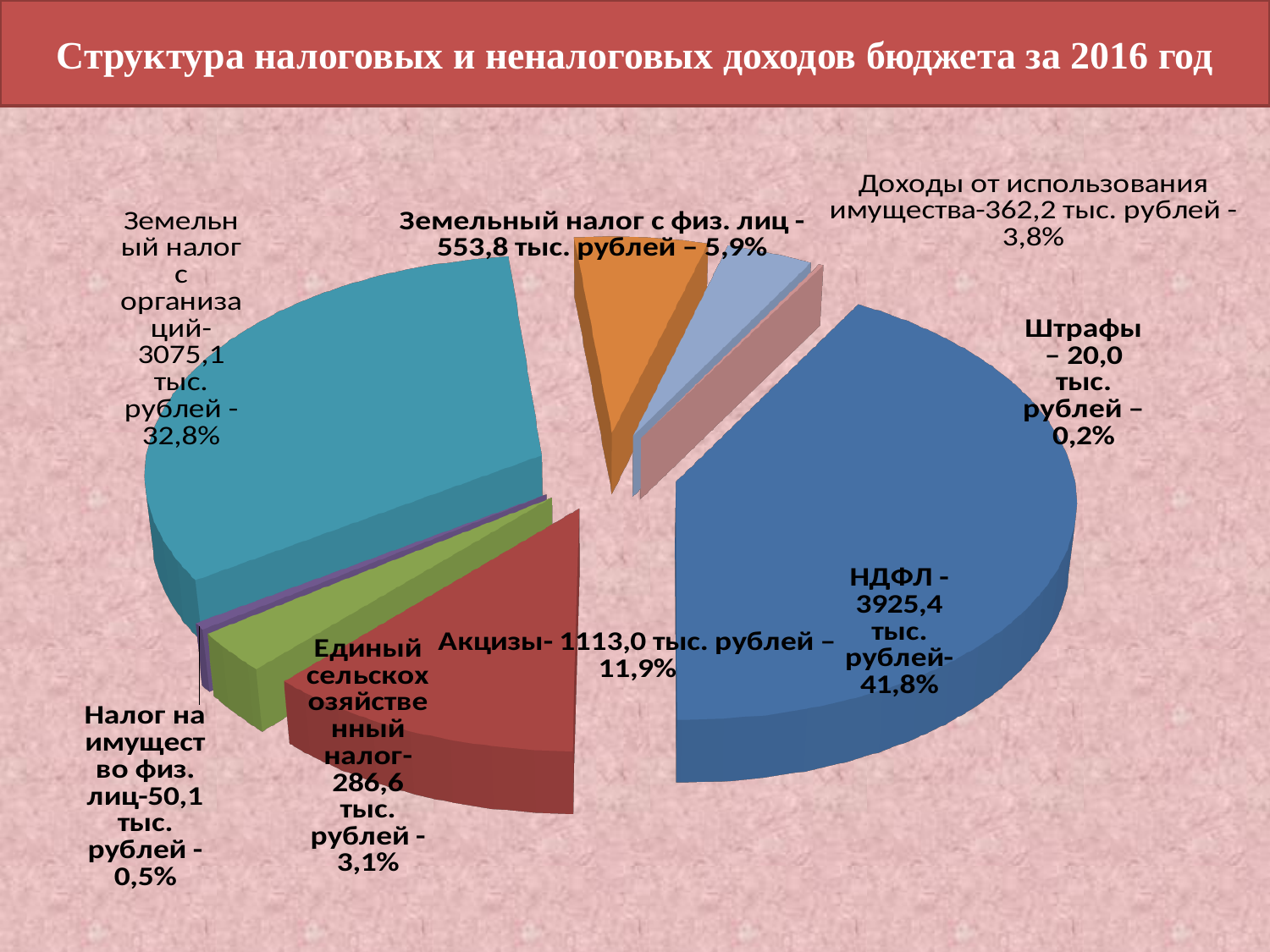
How many slices does the pie chart have? 8 What is the title of the slide? Структура налоговых и неналоговых доходов бюджета за 2016 год Which is larger: Единый сельскохозяйственный налог or Налог на имущество физ. лиц? Единый сельскохозяйственный налог What is the value for Штрафы? 20,0 тыс. рублей Which category has the smallest share of the pie? Штрафы What share of the pie does Акцизы represent? 11,9% Which category has the largest share of the pie? НДФЛ What kind of chart is shown on the slide? Pie chart What share of the pie does Доходы от использования имущества represent? 3,8% What is the difference in percentage points between НДФЛ and Земельный налог с организаций? 9,0 What is the value for НДФЛ? 3925,4 тыс. рублей What is the value for Земельный налог с физ. лиц? 553,8 тыс. рублей